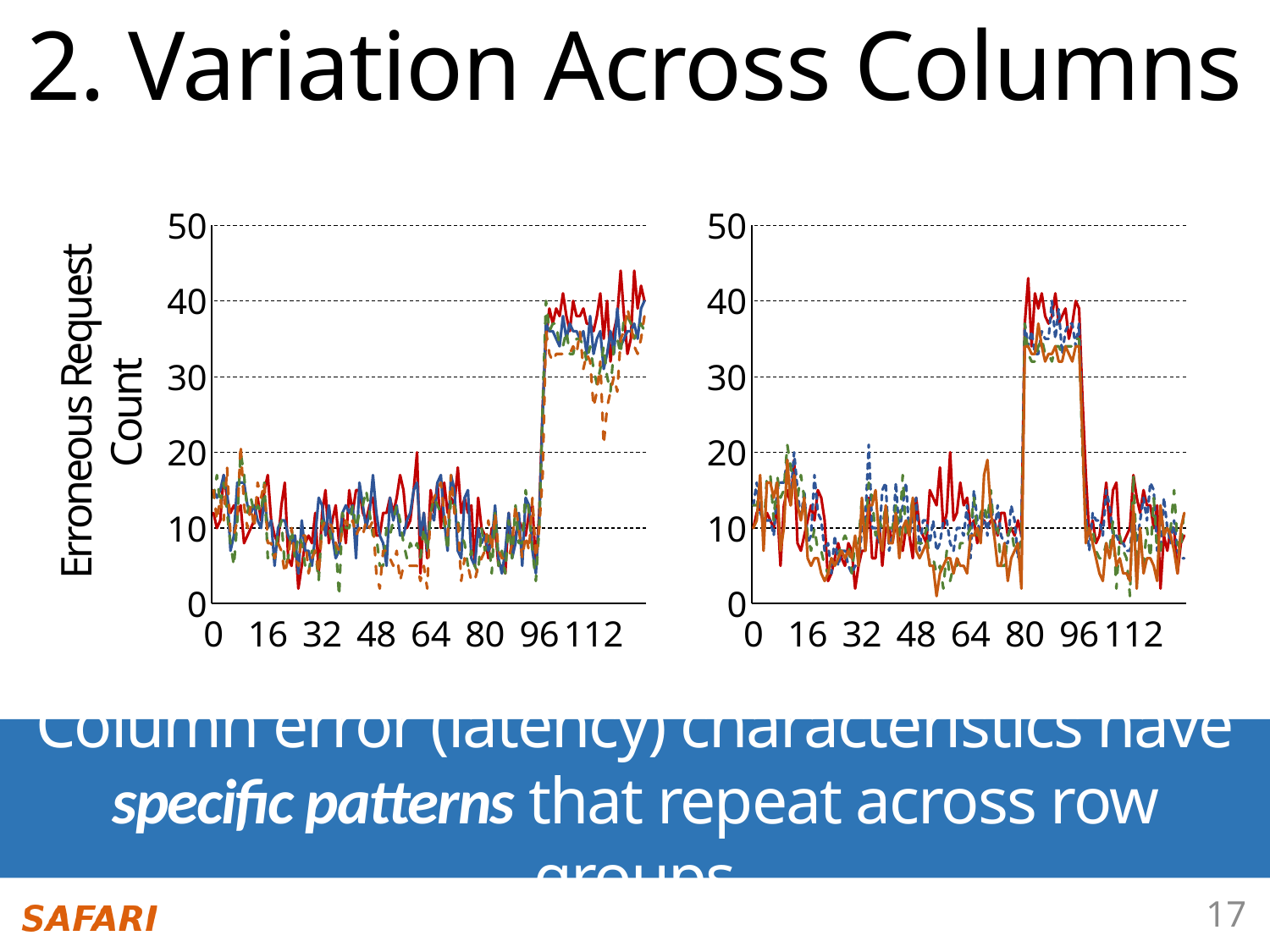
What is the highest value shown on the y-axis of the left chart? 50 In the right chart, do the values rise or fall sharply just after x = 96? fall In the left chart, which is larger: the values around x = 112 or the values around x = 32? the values around x = 112 How many charts are shown on the slide? 2 What kind of chart is the left chart on the slide? line chart In the right chart, are the values at x = 88 greater or less than 30? greater In the right chart, are the values at x = 112 greater or less than 20? less What is the y-axis label of the left chart? Erroneous Request Count What kind of chart is the right chart on the slide? line chart In the left chart, are the values at x = 48 greater or less than 20? less In the left chart, do the values rise or fall sharply just after x = 96? rise